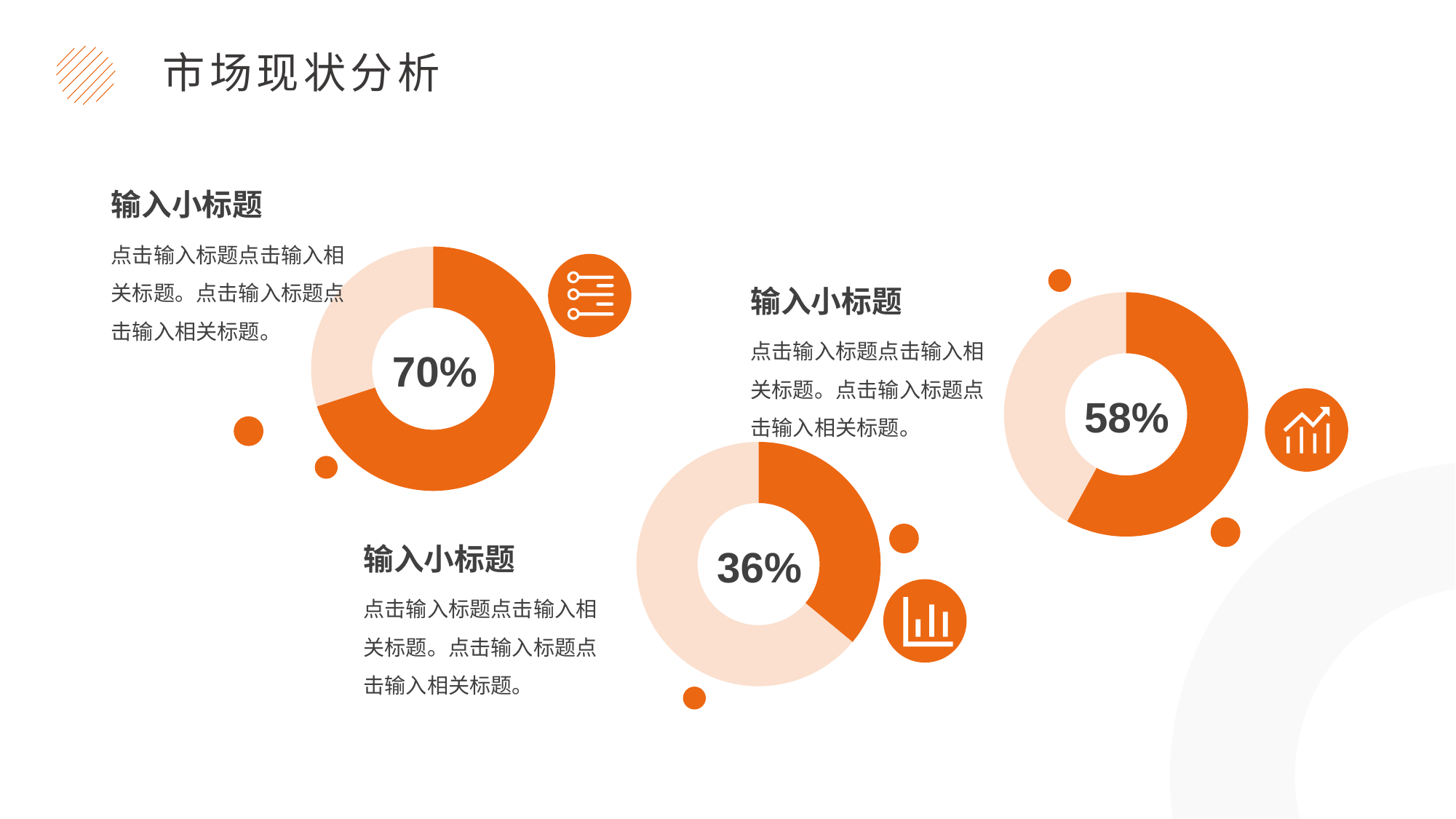
Is the percentage in the top-right donut chart larger or smaller than the one in the bottom-middle donut chart? Larger What is the difference between the percentages shown in the top-right and bottom-middle donut charts? 22% What is the title of the slide? 市场现状分析 What percentage is shown in the centre of the bottom-middle donut chart? 36% In the bottom-middle donut chart, what share of the ring is filled with the dark orange colour? 36% What percentage is shown in the centre of the top-left donut chart? 70% What percentage is shown in the centre of the top-right donut chart? 58% How many donut charts are on the slide? 3 Which donut chart shows the lowest percentage: top-left, bottom-middle, or top-right? Bottom-middle (36%) What kind of chart is used for each of the three charts on the slide? Donut (pie) chart What is the difference between the percentages shown in the top-left and top-right donut charts? 12% Which donut chart shows the highest percentage: top-left, bottom-middle, or top-right? Top-left (70%)